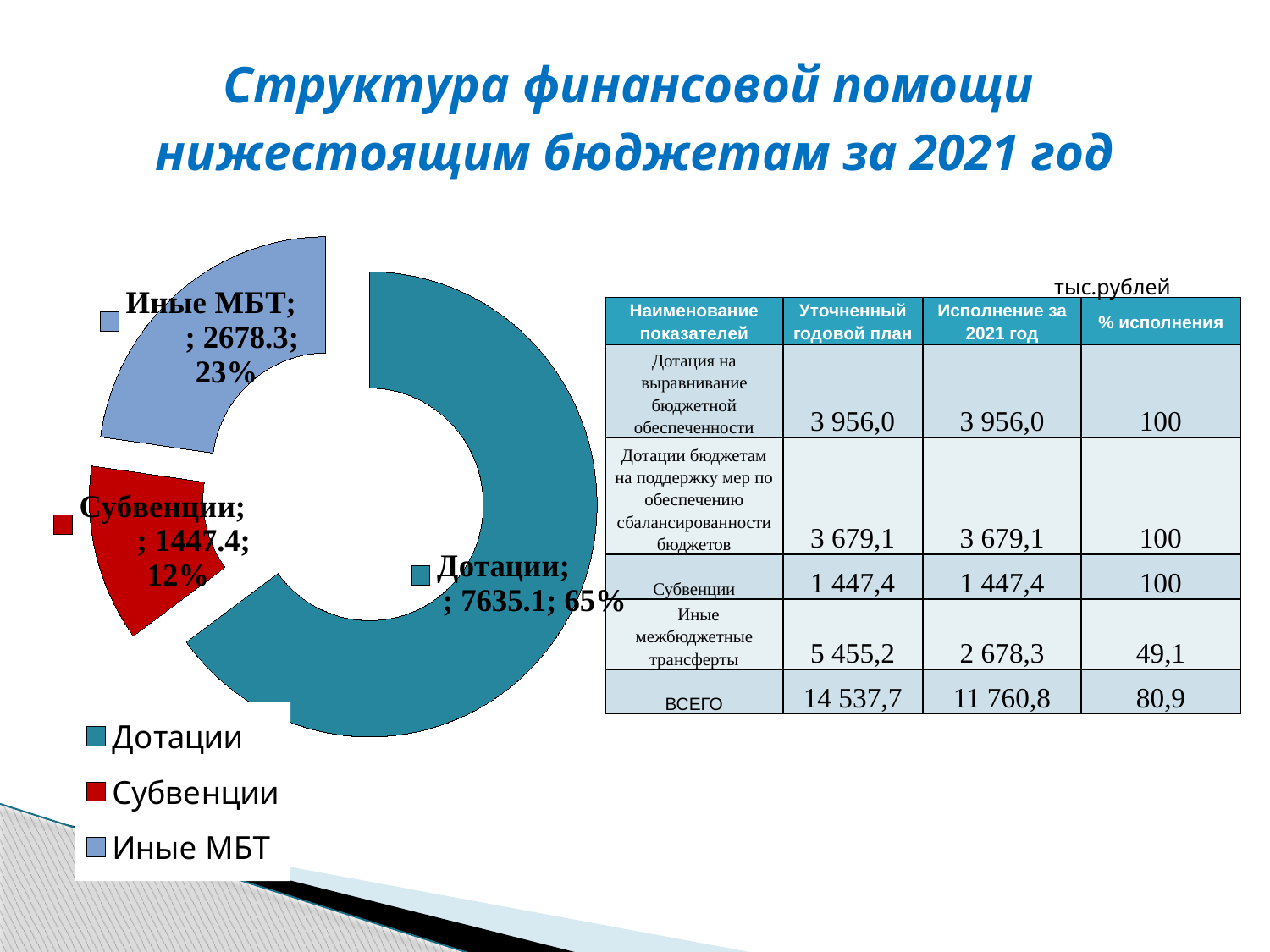
Which category has the largest slice in the chart? Дотации What is the difference between the values for Дотации and Иные МБТ? 4956.8 What share of the chart does Дотации represent? 65% What value is shown for Дотации in the chart? 7635.1 What value is shown for Субвенции in the chart? 1447.4 What value is shown for Иные МБТ in the chart? 2678.3 What share of the chart does Субвенции represent? 12% How many categories are shown in the chart? 3 What type of chart is shown on the slide? Doughnut (pie) chart Which category has the smallest slice in the chart? Субвенции What share of the chart does Иные МБТ represent? 23% Which is larger, the value for Иные МБТ or the value for Субвенции? Иные МБТ